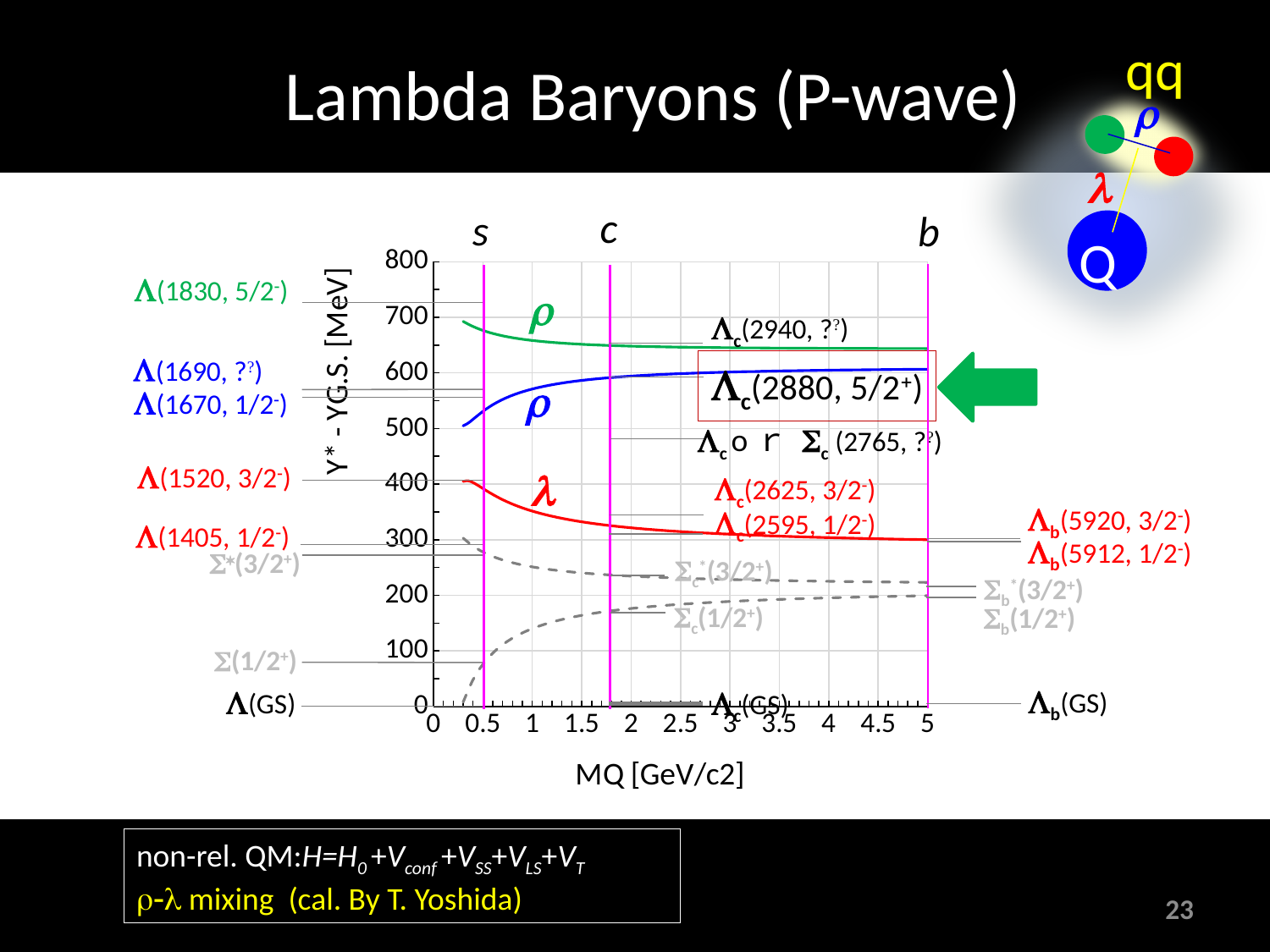
What is the maximum value shown on the y axis of the chart? 800 What kind of chart is shown on the slide? line chart At the vertical line labelled s, is the green ρ curve greater or less than 600 MeV? greater What is the label of the y axis of the chart? Y* - YG.S. [MeV] At the vertical line labelled s, which curve is higher, the green ρ curve or the blue ρ curve? green ρ curve Does the blue ρ curve rise or fall as MQ increases? rise How many vertical magenta lines (labelled s, c, b) are drawn on the chart? 3 What is the label of the x axis of the chart? MQ [GeV/c2] Does the green ρ curve rise or fall as MQ increases? fall At the vertical line labelled c, is the red λ curve greater or less than 400 MeV? less Does the red λ curve rise or fall as MQ increases? fall At the vertical line labelled s, is the blue ρ curve greater or less than 600 MeV? less